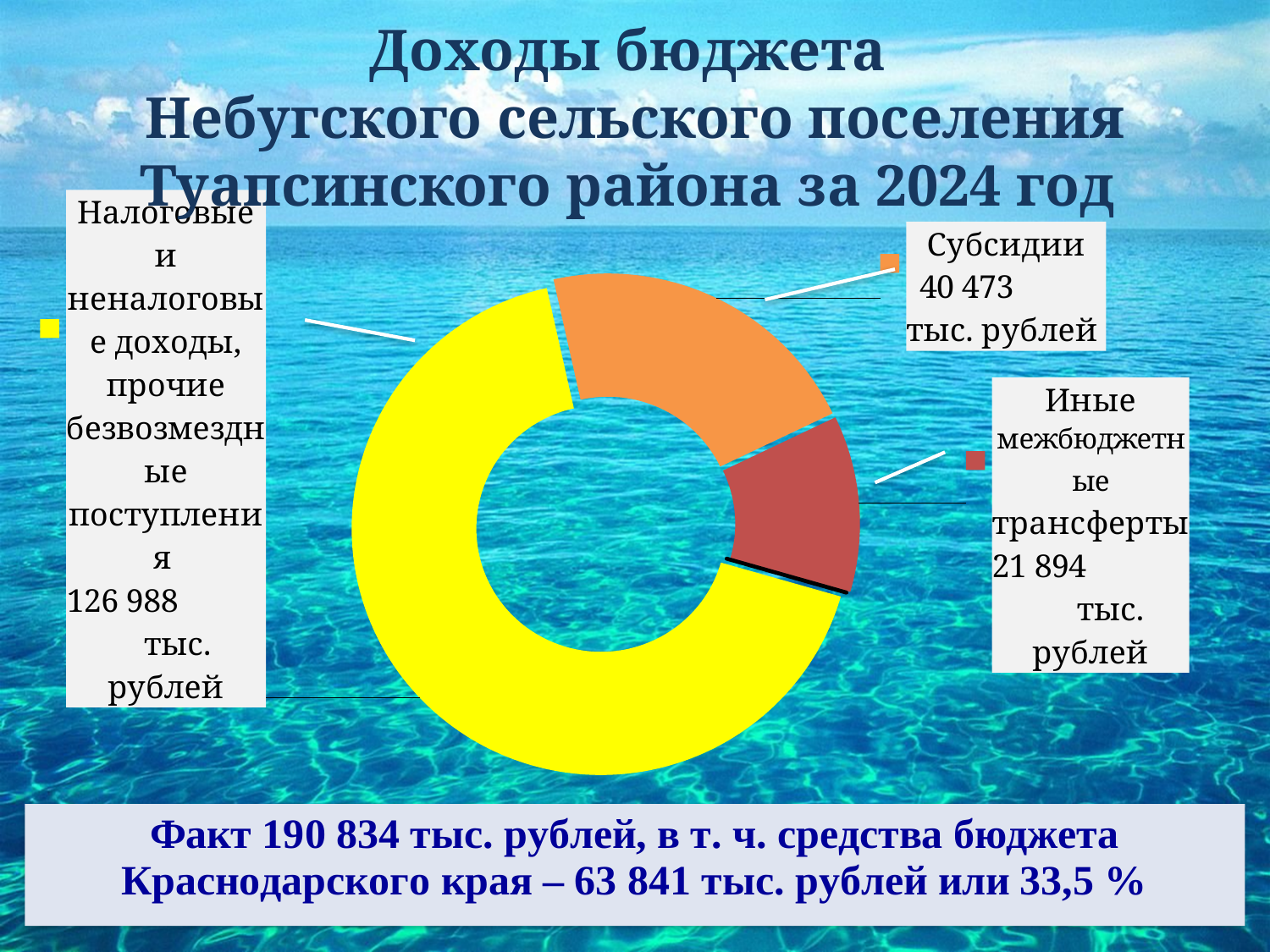
Which category has the smallest value in the chart? Иные межбюджетные трансферты How many segments does the doughnut chart have? 3 What is the difference between Налоговые и неналоговые доходы, прочие безвозмездные поступления and Субсидии? 86 515 тыс. рублей Which is larger: Субсидии or Иные межбюджетные трансферты? Субсидии What is the value for Субсидии? 40 473 тыс. рублей What is the value for Налоговые и неналоговые доходы, прочие безвозмездные поступления? 126 988 тыс. рублей What type of chart is shown on the slide? Doughnut chart What colour is the segment for Субсидии? Orange What is the difference between Субсидии and Иные межбюджетные трансферты? 18 579 тыс. рублей What colour is the segment for Иные межбюджетные трансферты? Red What is the value for Иные межбюджетные трансферты? 21 894 тыс. рублей Which category has the largest value in the chart? Налоговые и неналоговые доходы, прочие безвозмездные поступления